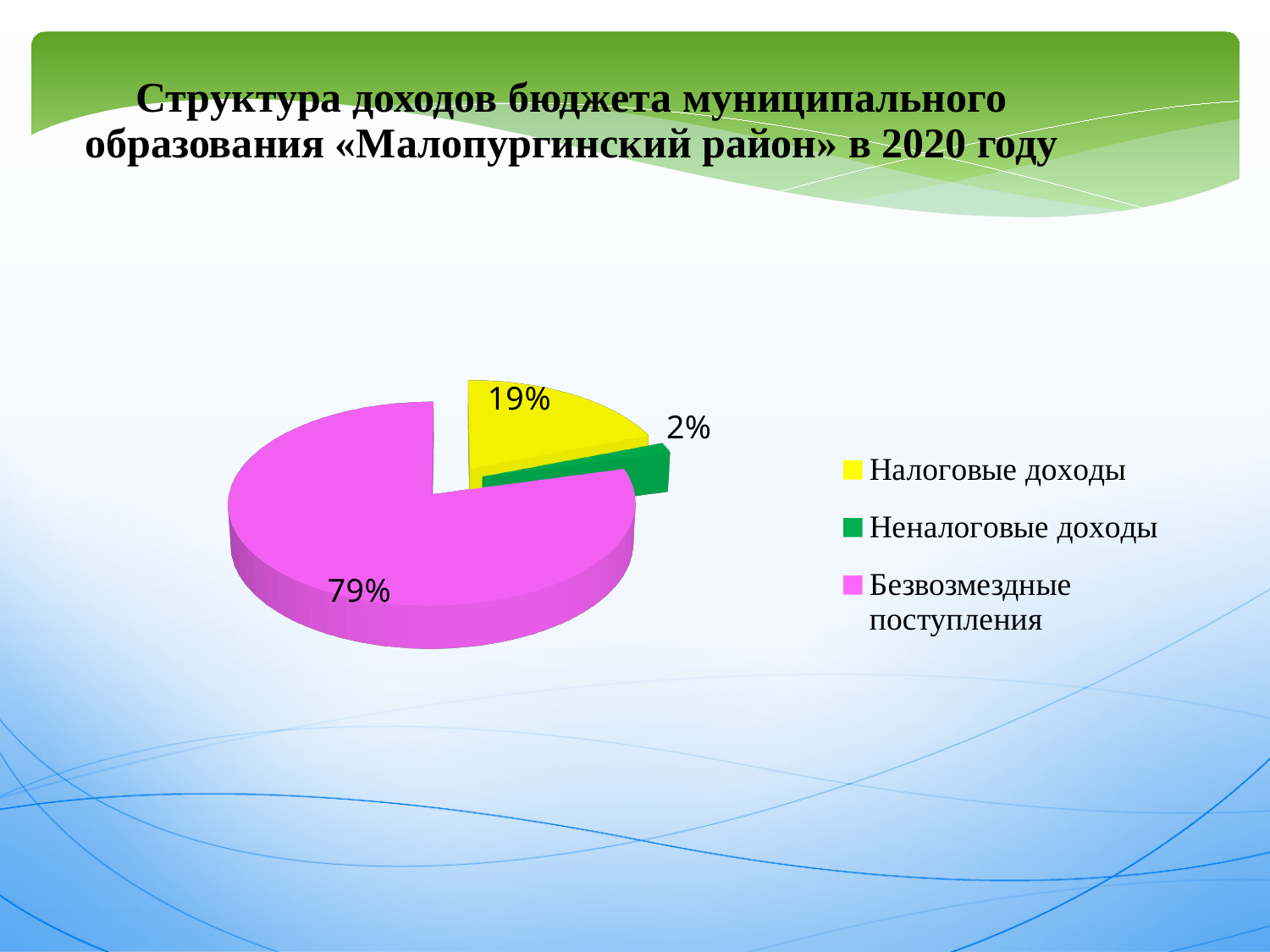
What is the difference in percentage points between Налоговые доходы and Неналоговые доходы? 17 How many categories does the pie chart show? 3 What share of the pie is Безвозмездные поступления? 79% What is the difference in percentage points between Безвозмездные поступления and Налоговые доходы? 60 What kind of chart is shown on the slide? Pie chart What share of the pie is Налоговые доходы? 19% Which is larger, Налоговые доходы or Неналоговые доходы? Налоговые доходы What colour is the slice for Безвозмездные поступления? Pink What share of the pie is Неналоговые доходы? 2% Which category has the largest share of the pie? Безвозмездные поступления Which category is shown in yellow in the legend? Налоговые доходы Which category has the smallest share of the pie? Неналоговые доходы